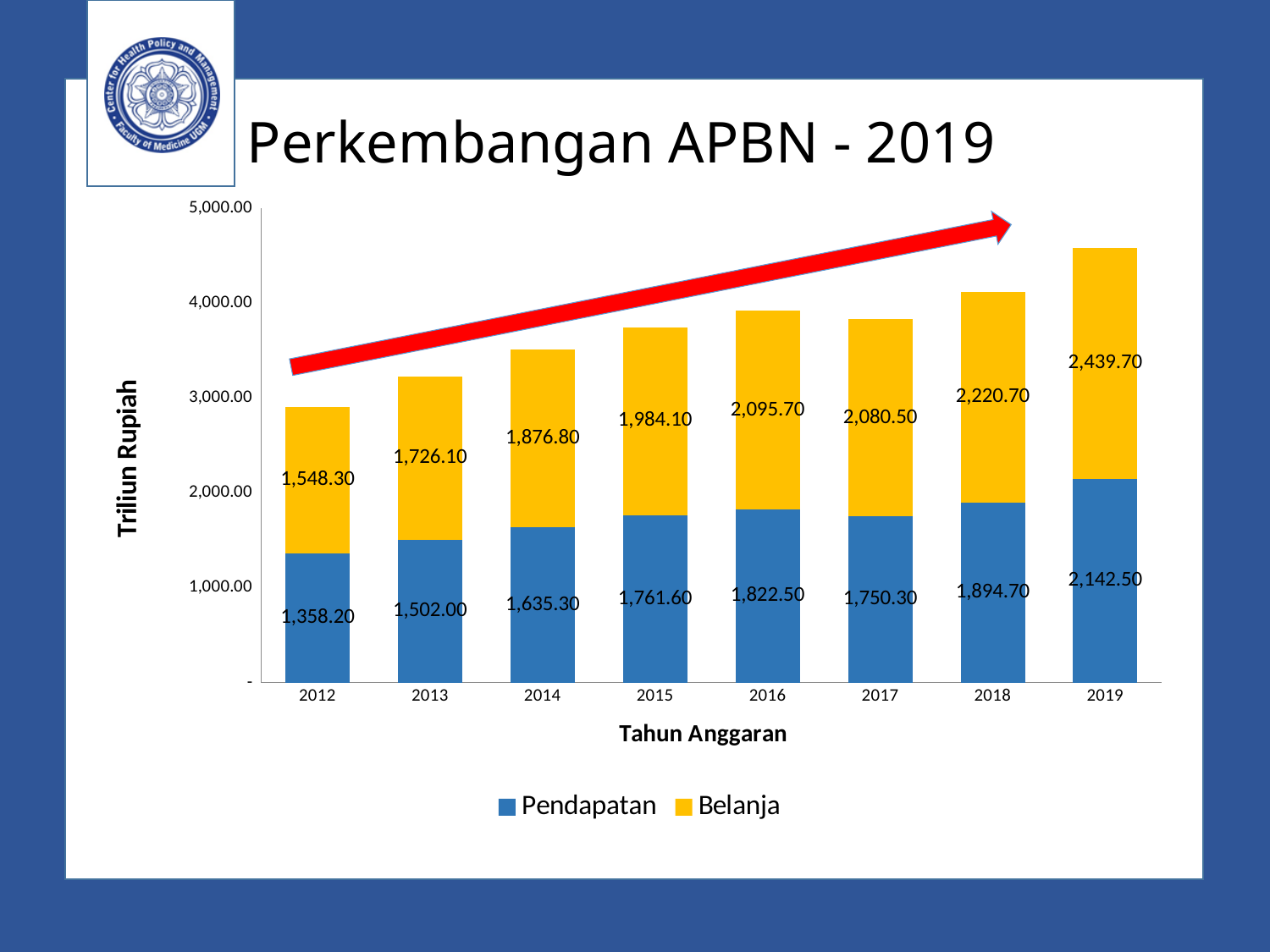
What is the Pendapatan value for 2019? 2,142.50 How many years are shown on the x axis? 8 What is the Pendapatan value for 2017? 1,750.30 Which is larger, Pendapatan in 2016 or Pendapatan in 2017? Pendapatan in 2016 Is the total height of the stacked bar for 2019 greater or less than 4,000.00? greater What is the total of the stacked bar for 2012 (Pendapatan plus Belanja)? 2,906.50 Which year has the highest Belanja value? 2019 What is the difference between Belanja and Pendapatan in 2019? 297.20 How many series does the legend list? 2 What kind of chart is shown on the slide? Stacked bar chart Which year has the lowest Pendapatan value? 2012 What is the Belanja value for 2015? 1,984.10